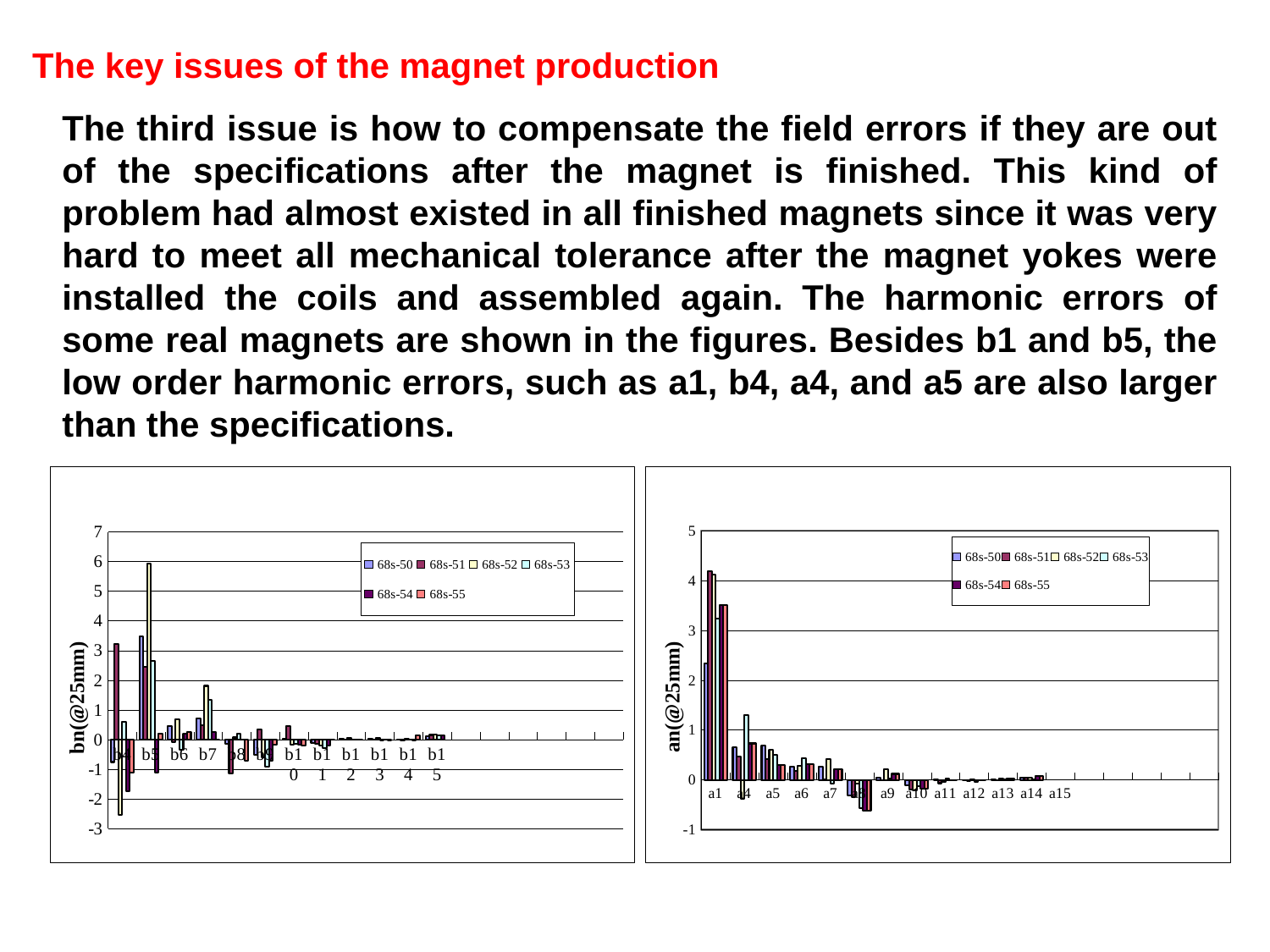
What is the y-axis label of the left chart? bn(@25mm) In the left chart (bn(@25mm)), which category has the tallest bar? b5 In the right chart (an(@25mm)), which category has the tallest bar? a1 How many series does the legend of the right chart (an(@25mm)) list? 6 In the right chart (an(@25mm)), is the 68s-51 value larger at a1 or at a4? a1 What is the y-axis label of the right chart? an(@25mm) How many categories are shown on the x axis of the right chart (an(@25mm))? 13 What kind of chart is the left chart with the bn(@25mm) axis? bar chart In the right chart (an(@25mm)), is the value for 68s-51 at a1 greater or less than 4? greater In the left chart (bn(@25mm)), is the value for 68s-53 at b4 greater or less than -2? greater In the left chart (bn(@25mm)), is the value for 68s-52 at b5 greater or less than 5? greater